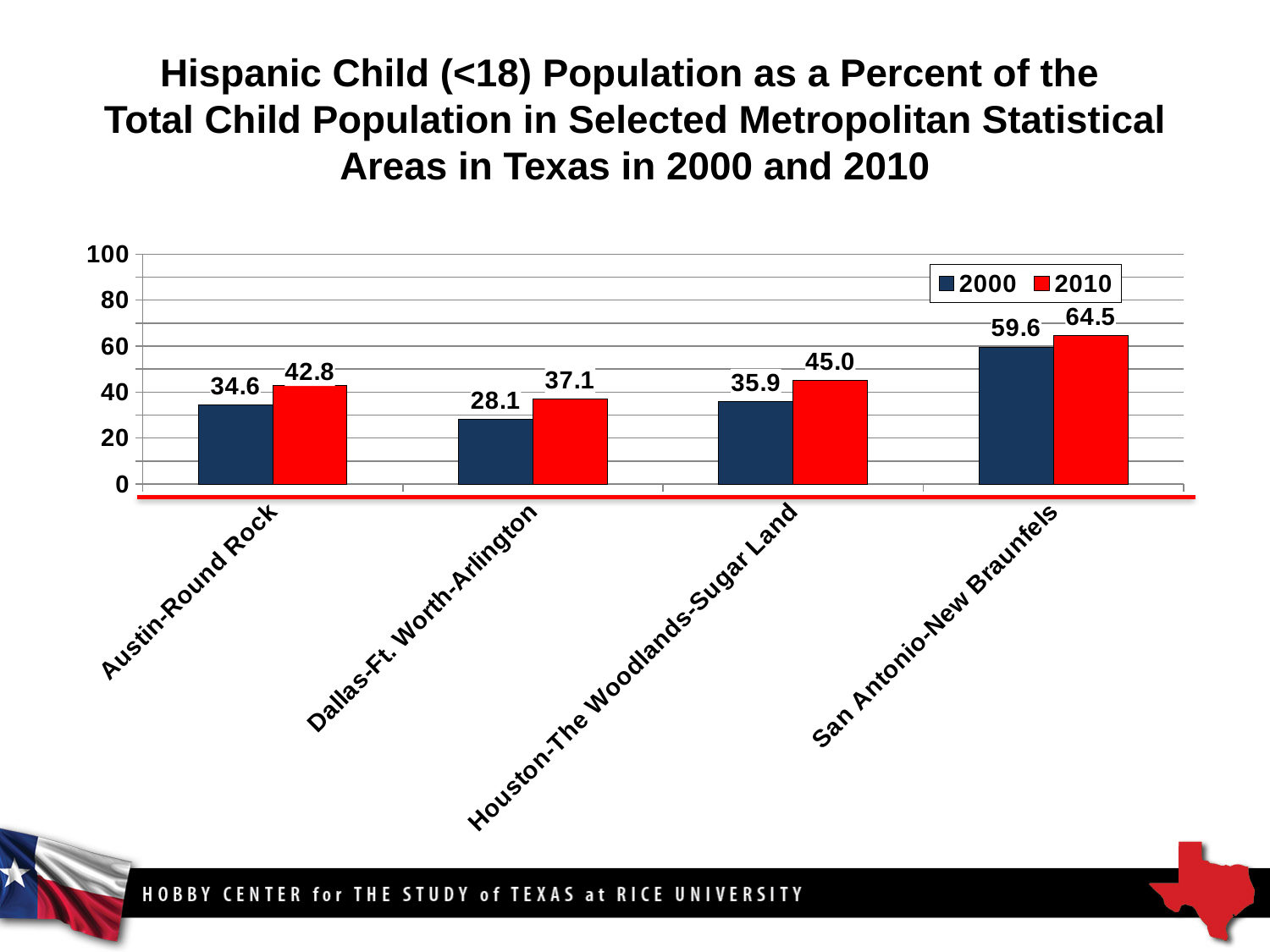
How many series does the legend list? 2 Which metropolitan area has the lowest 2000 value? Dallas-Ft. Worth-Arlington What is the 2010 value for Houston-The Woodlands-Sugar Land? 45.0 What is the difference between the 2010 values for Houston-The Woodlands-Sugar Land and Dallas-Ft. Worth-Arlington? 7.9 Which is larger: the 2000 value for Austin-Round Rock or the 2000 value for Houston-The Woodlands-Sugar Land? Houston-The Woodlands-Sugar Land Is the 2000 value for San Antonio-New Braunfels greater or less than 40? greater What is the difference between the 2010 and 2000 values for San Antonio-New Braunfels? 4.9 Which metropolitan area has the highest 2010 value? San Antonio-New Braunfels How many metropolitan areas are shown on the x axis? 4 What is the 2000 value for Dallas-Ft. Worth-Arlington? 28.1 What is the 2010 value for Austin-Round Rock? 42.8 What kind of chart is shown on the slide? Bar chart